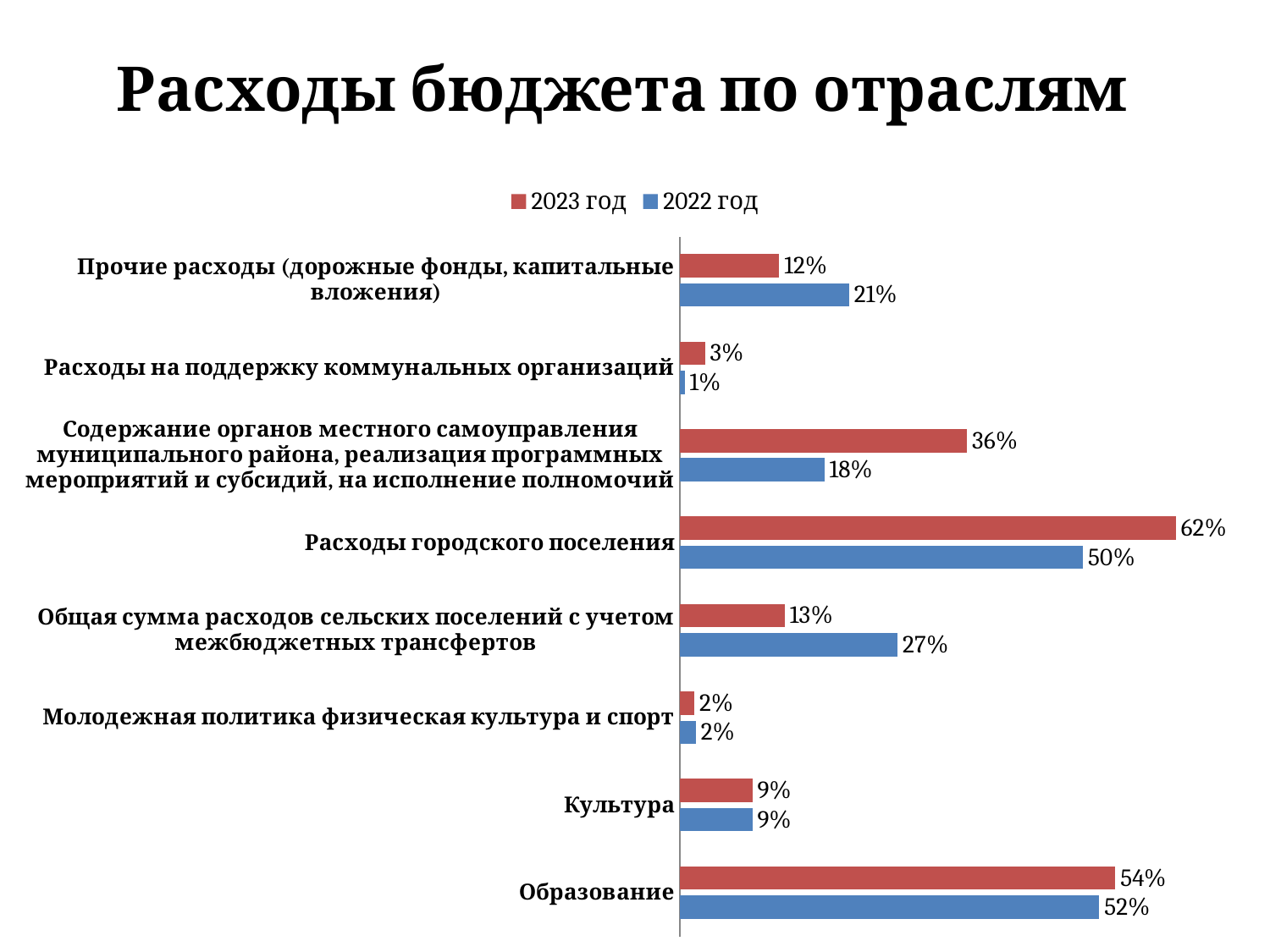
How many series does the legend list? 2 How many categories are shown on the chart? 8 Which colour represents 2022 год in the chart? Blue What is the value for Культура in 2023 год? 9% What is the difference between the 2023 год and 2022 год values for Расходы городского поселения? 12% Which category has the highest value for 2023 год? Расходы городского поселения What kind of chart is shown on the slide? Bar chart Which is larger for Общая сумма расходов сельских поселений с учетом межбюджетных трансфертов: the 2023 год value or the 2022 год value? 2022 год What is the value for Образование in 2023 год? 54% Which category has the lowest value for 2022 год? Расходы на поддержку коммунальных организаций What is the title of the chart? Расходы бюджета по отраслям What is the value for Расходы городского поселения in 2022 год? 50%